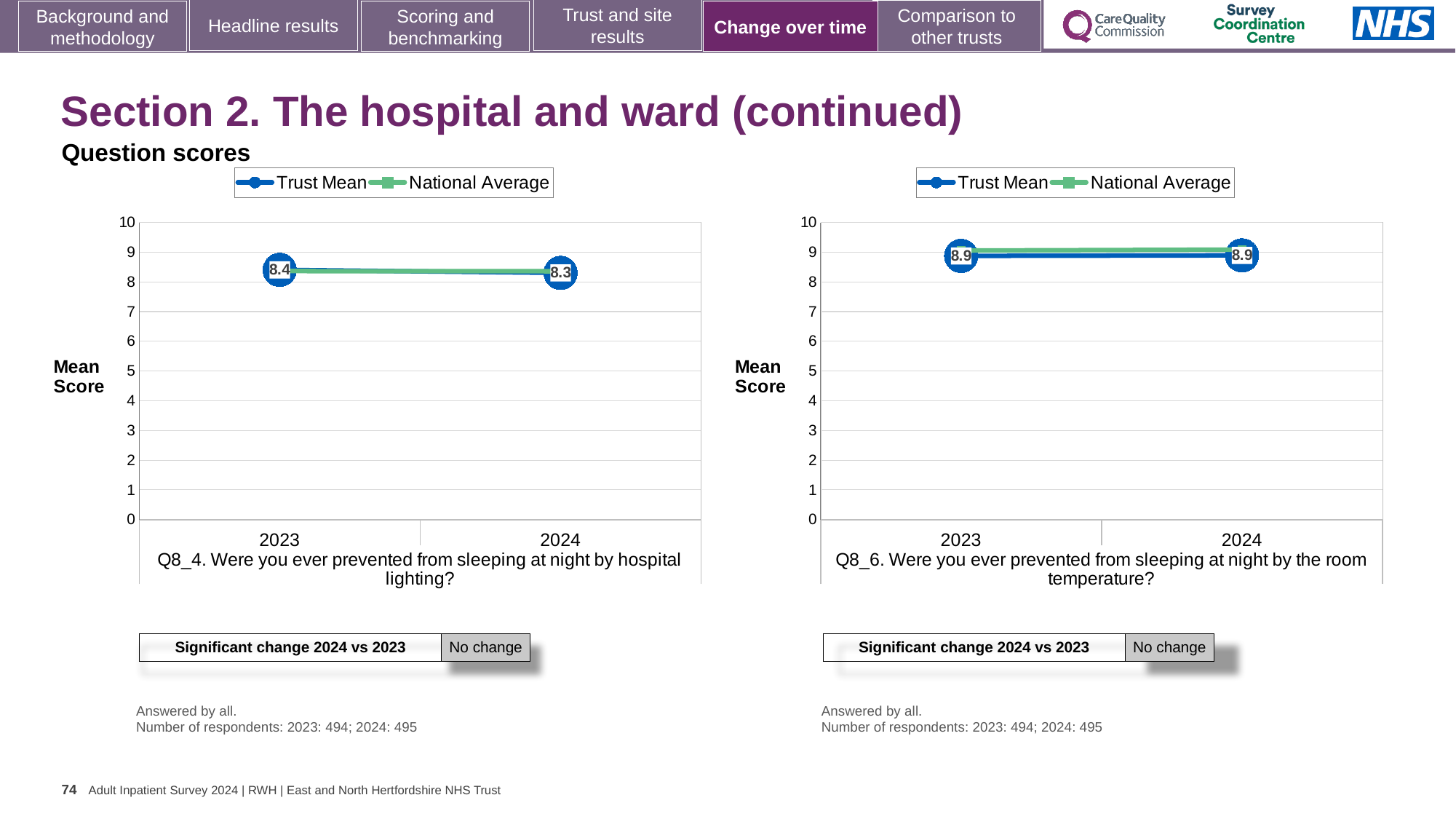
In the right chart (Q8_6, room temperature), does the Trust Mean rise, fall or stay the same from 2023 to 2024? stay the same How many series does the legend of the left chart (Q8_4, hospital lighting) list? 2 In the left chart (Q8_4, hospital lighting), does the Trust Mean rise or fall from 2023 to 2024? fall In the right chart (Q8_6, room temperature), is the National Average for 2023 greater or less than 8? greater In the left chart (Q8_4, hospital lighting), what is the Trust Mean score for 2024? 8.3 In the right chart (Q8_6, room temperature), what is the Trust Mean score for 2023? 8.9 In the right chart (Q8_6, room temperature), what is the Trust Mean score for 2024? 8.9 In the left chart (Q8_4, hospital lighting), is the National Average for 2024 greater or less than 7? greater What kind of chart is the left chart (Q8_4, hospital lighting)? line chart In the left chart (Q8_4, hospital lighting), what is the Trust Mean score for 2023? 8.4 In the left chart (Q8_4, hospital lighting), what is the difference between the Trust Mean scores for 2023 and 2024? 0.1 How many years are plotted on the x axis of the right chart (Q8_6, room temperature)? 2